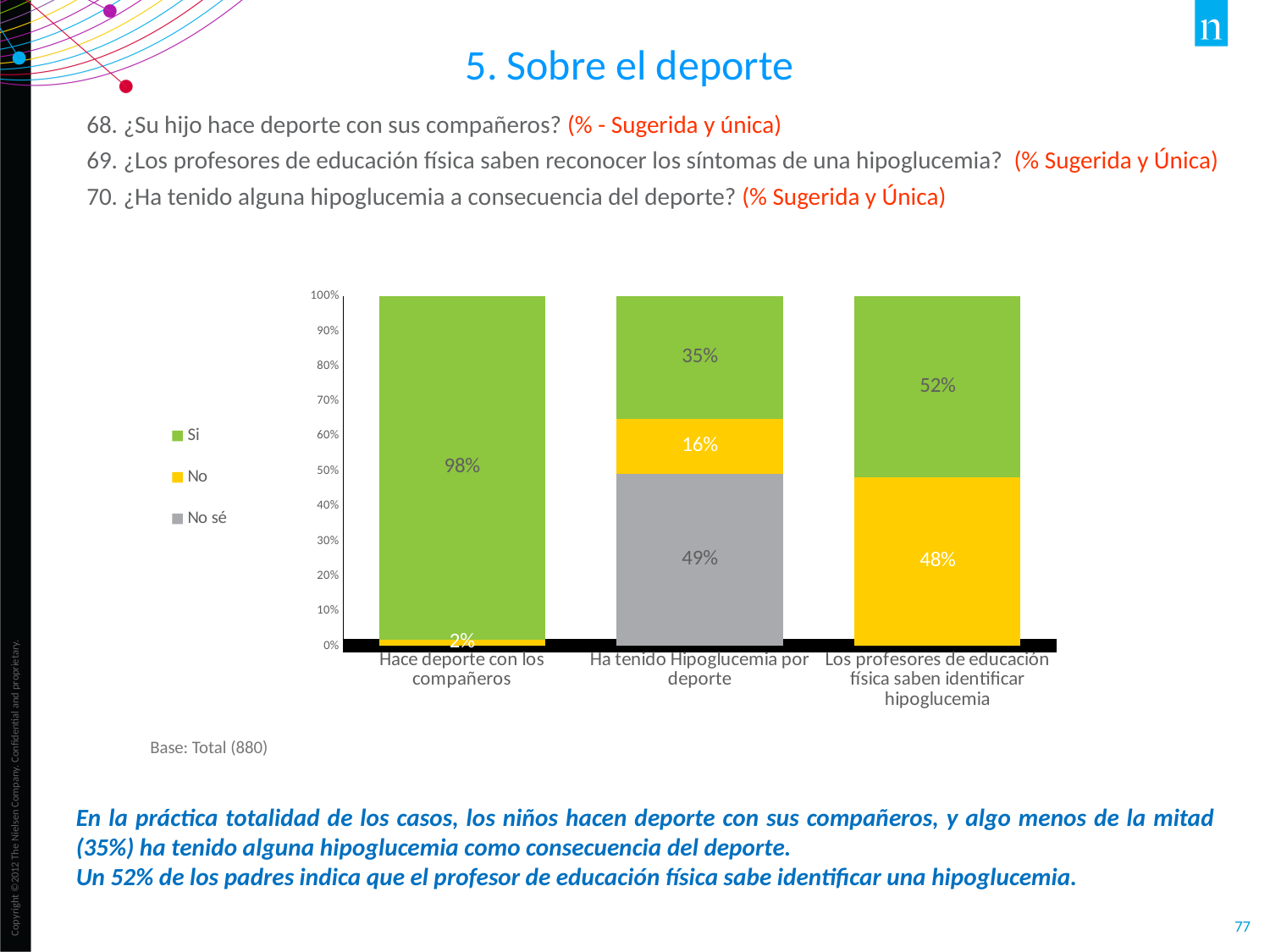
Which category has the highest 'Si' value? Hace deporte con los compañeros What is the 'Si' value for 'Los profesores de educación física saben identificar hipoglucemia'? 52% For 'Ha tenido Hipoglucemia por deporte', which is larger, the 'Si' value or the 'No' value? Si What is the 'No' value for 'Hace deporte con los compañeros'? 2% What type of chart is shown on the slide? Stacked bar chart Which category has the lowest 'Si' value? Ha tenido Hipoglucemia por deporte What is the difference between the 'Si' and 'No' values for 'Los profesores de educación física saben identificar hipoglucemia'? 4% What is the 'No sé' value for 'Ha tenido Hipoglucemia por deporte'? 49% How many series does the legend list? 3 Which legend entry is shown in grey? No sé What is the 'Si' value for 'Hace deporte con los compañeros'? 98% How many categories are shown on the x axis? 3